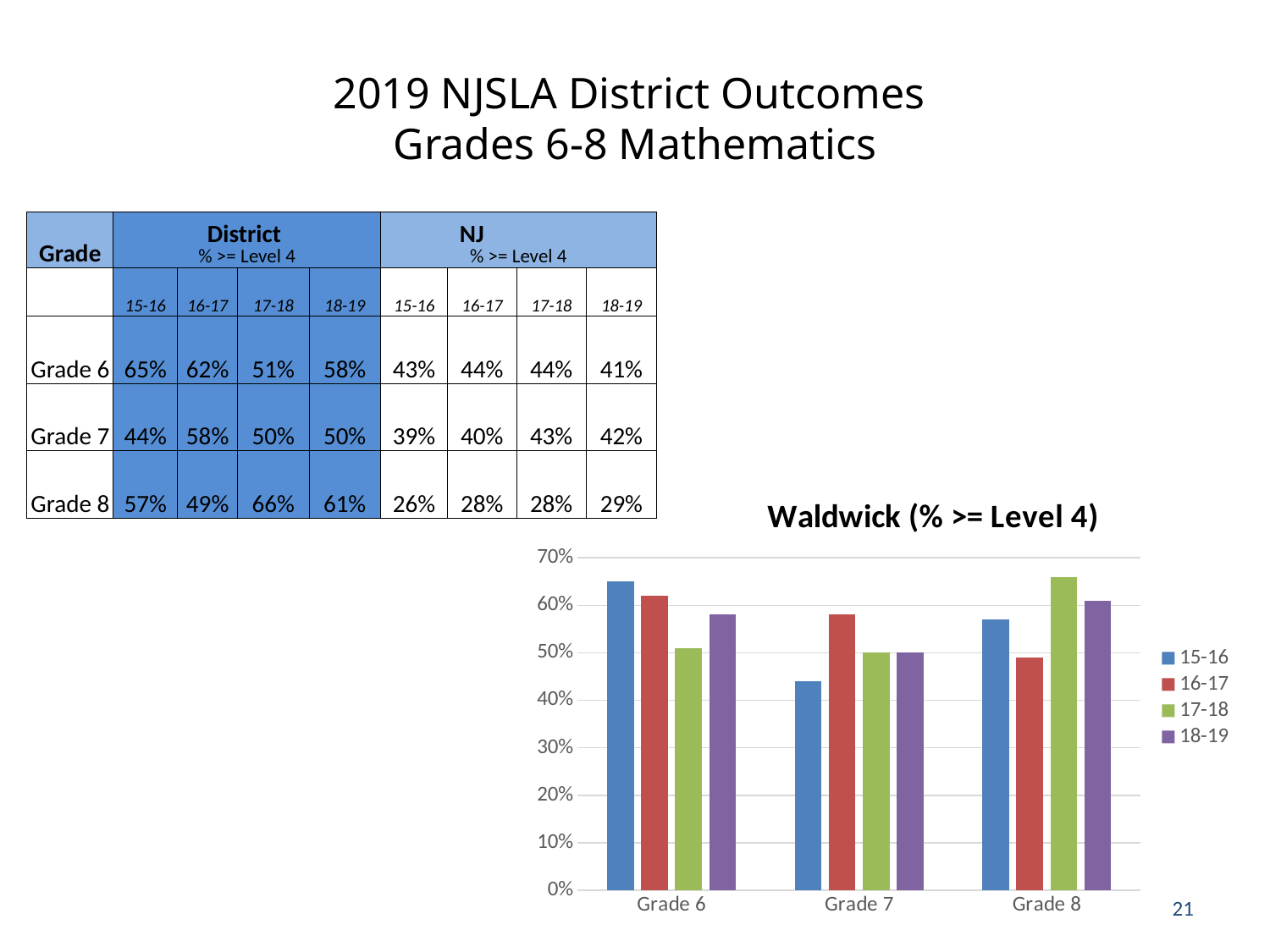
What type of chart is shown on the slide? Bar chart In the chart, which is larger: the 15-16 bar for Grade 6 or the 15-16 bar for Grade 8? Grade 6 How many series does the chart's legend list? 4 What colour represents the 18-19 series in the chart? Purple In the chart, which grade has the highest 17-18 bar? Grade 8 What is the District 17-18 value for Grade 8 plotted in the chart? 66% Is the 15-16 value for Grade 6 in the chart greater or less than 60%? greater In the chart, which is larger for Grade 7: the 16-17 bar or the 17-18 bar? 16-17 What is the title of the chart? Waldwick (% >= Level 4) How many grade categories are shown on the x axis of the chart? 3 Is the 15-16 value for Grade 7 in the chart greater or less than 50%? less In the chart, which grade has the lowest 15-16 bar? Grade 7